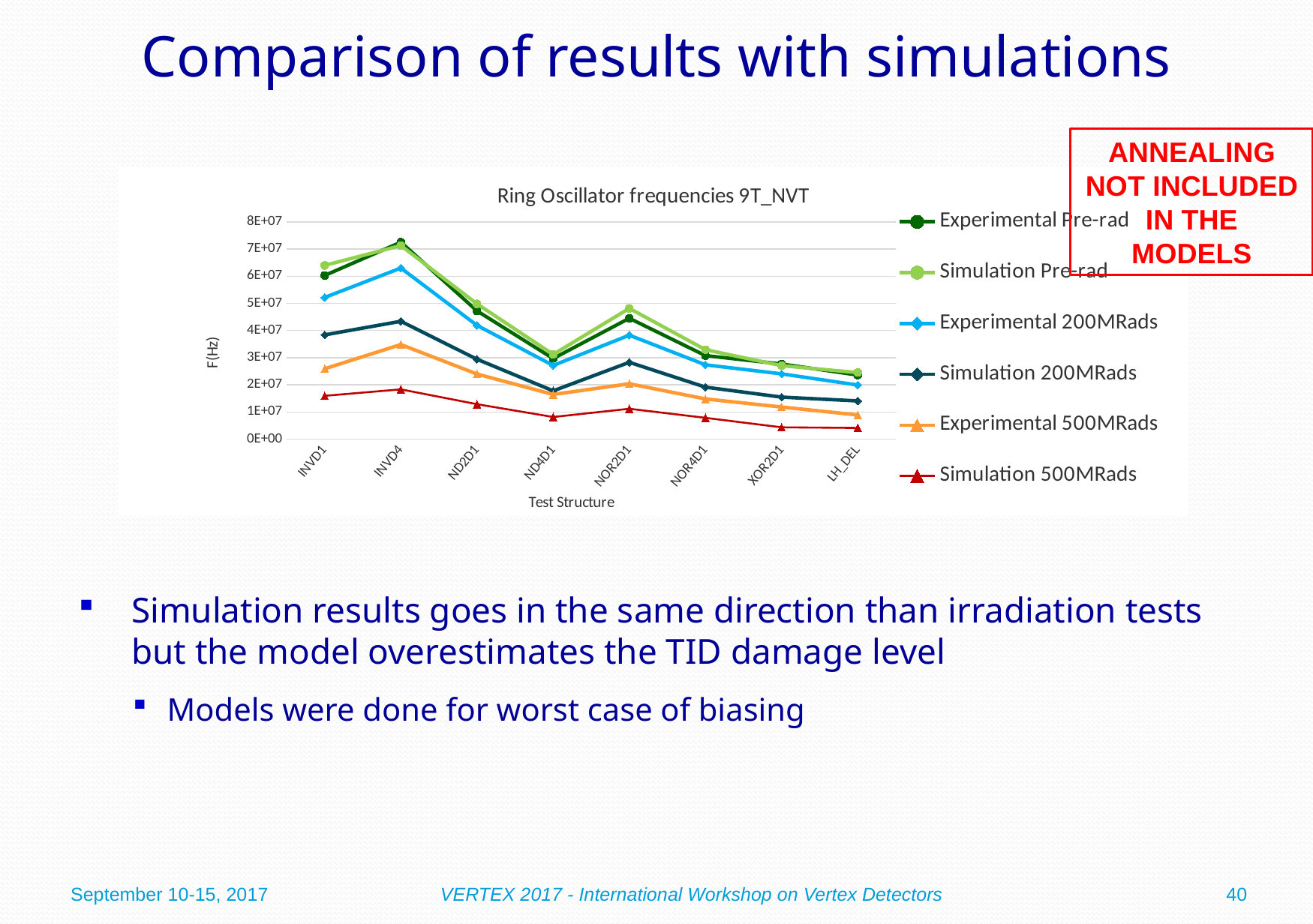
Is the Experimental 200MRads value for ND4D1 greater or less than 3E+07? less For which test structure is the Experimental Pre-rad frequency lowest? LH_DEL What kind of chart is shown on the slide? line chart Is the Simulation 200MRads value for INVD4 greater or less than 4E+07? greater For which test structure is the Experimental Pre-rad frequency highest? INVD4 How many series does the legend list? 6 What is the title of the chart? Ring Oscillator frequencies 9T_NVT Is the Simulation 500MRads value for INVD1 greater or less than 1E+07? greater How many test structures are plotted along the x axis? 8 Does the Experimental Pre-rad frequency rise or fall from INVD4 to ND4D1? fall At INVD4, which is larger: the Experimental 500MRads value or the Simulation 500MRads value? Experimental 500MRads What is the label of the y axis? F(Hz)